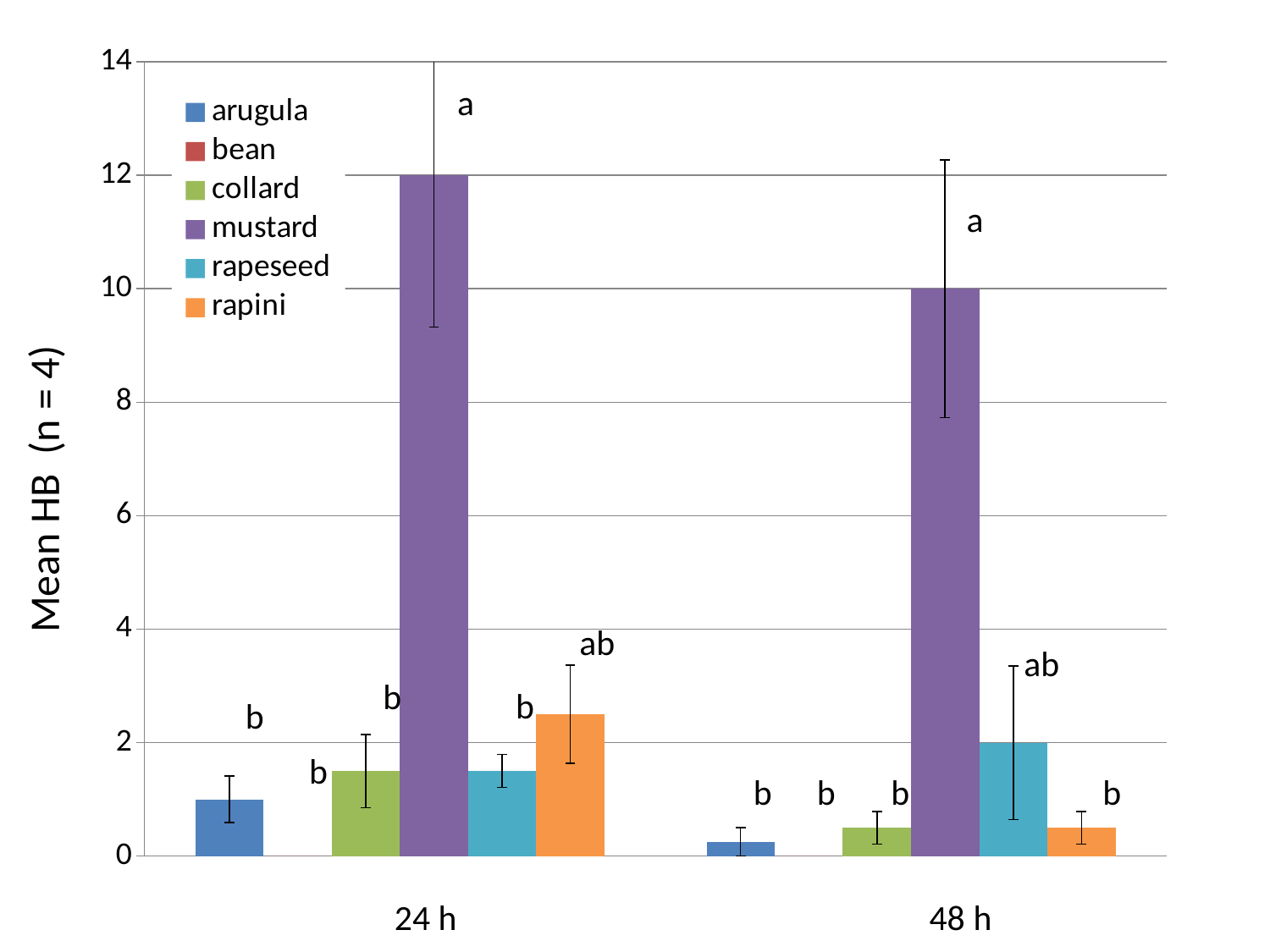
What is the Mean HB value for mustard at 48 h? 10 Which series has the highest value at 24 h? mustard How many time-point categories are shown on the x axis? 2 Which series has the highest value at 48 h? mustard Is the mustard value larger at 24 h or at 48 h? 24 h What is the Mean HB value for mustard at 24 h? 12 What is the Mean HB value for rapeseed at 48 h? 2 How many series does the legend list? 6 What kind of chart is shown on the slide? bar chart Is the value for rapini at 24 h greater or less than 4? less What is the difference between the mustard values at 24 h and 48 h? 2 What is the label on the y axis? Mean HB (n = 4)